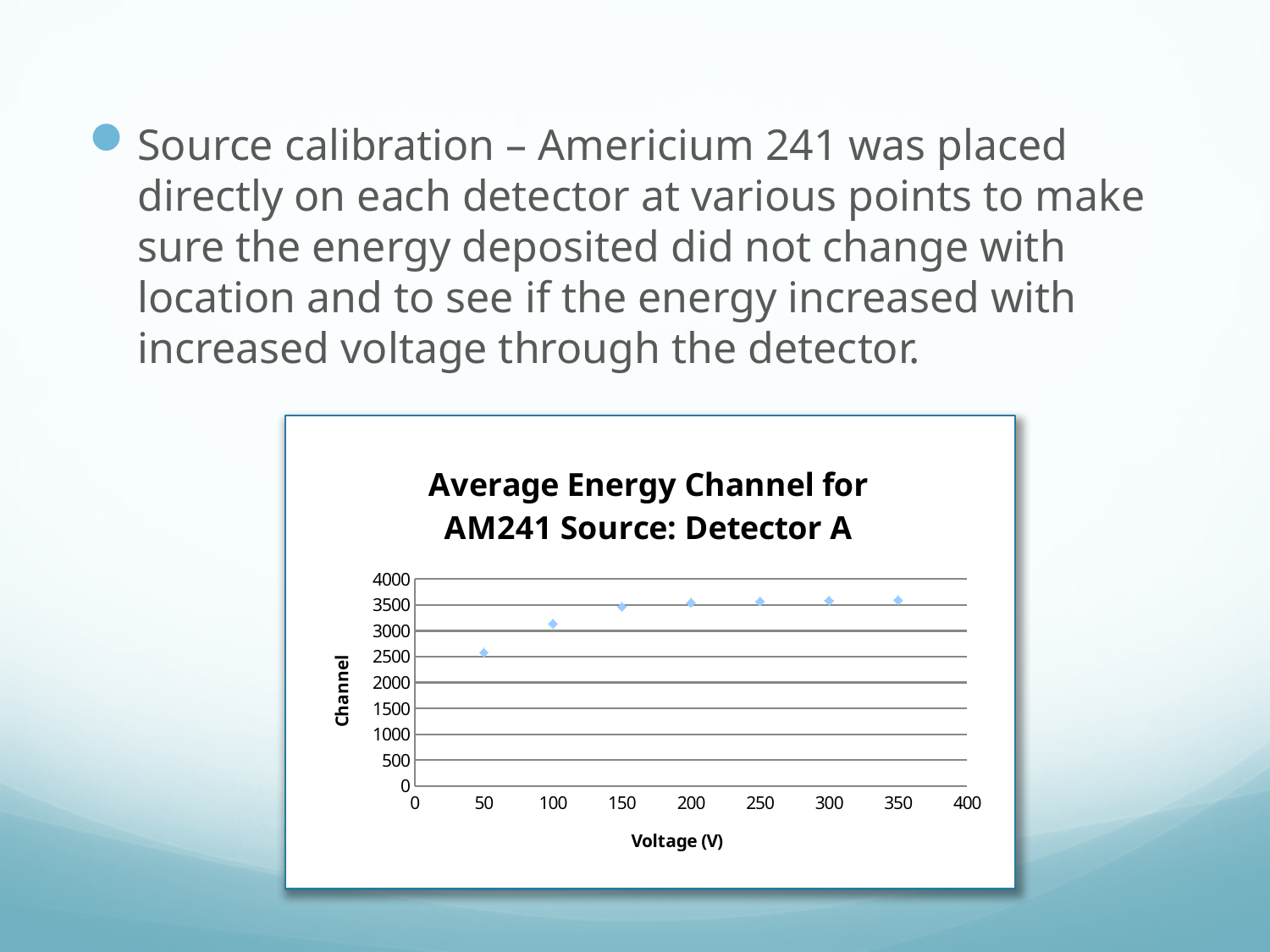
Is the channel value at 100 V greater or less than 3000? greater How many data points are plotted on the chart? 7 Do the channel values rise or fall as voltage increases along the x axis? Rise Which has the larger channel value, 50 V or 100 V? 100 V What kind of chart is shown on the slide? Scatter chart Is the channel value at 300 V greater or less than 3000? greater Is the channel value at 50 V greater or less than 3000? less What is the title of the chart? Average Energy Channel for AM241 Source: Detector A What is the label of the x axis of the chart? Voltage (V) At which voltage is the channel value lowest? 50 Which has the larger channel value, 50 V or 350 V? 350 V